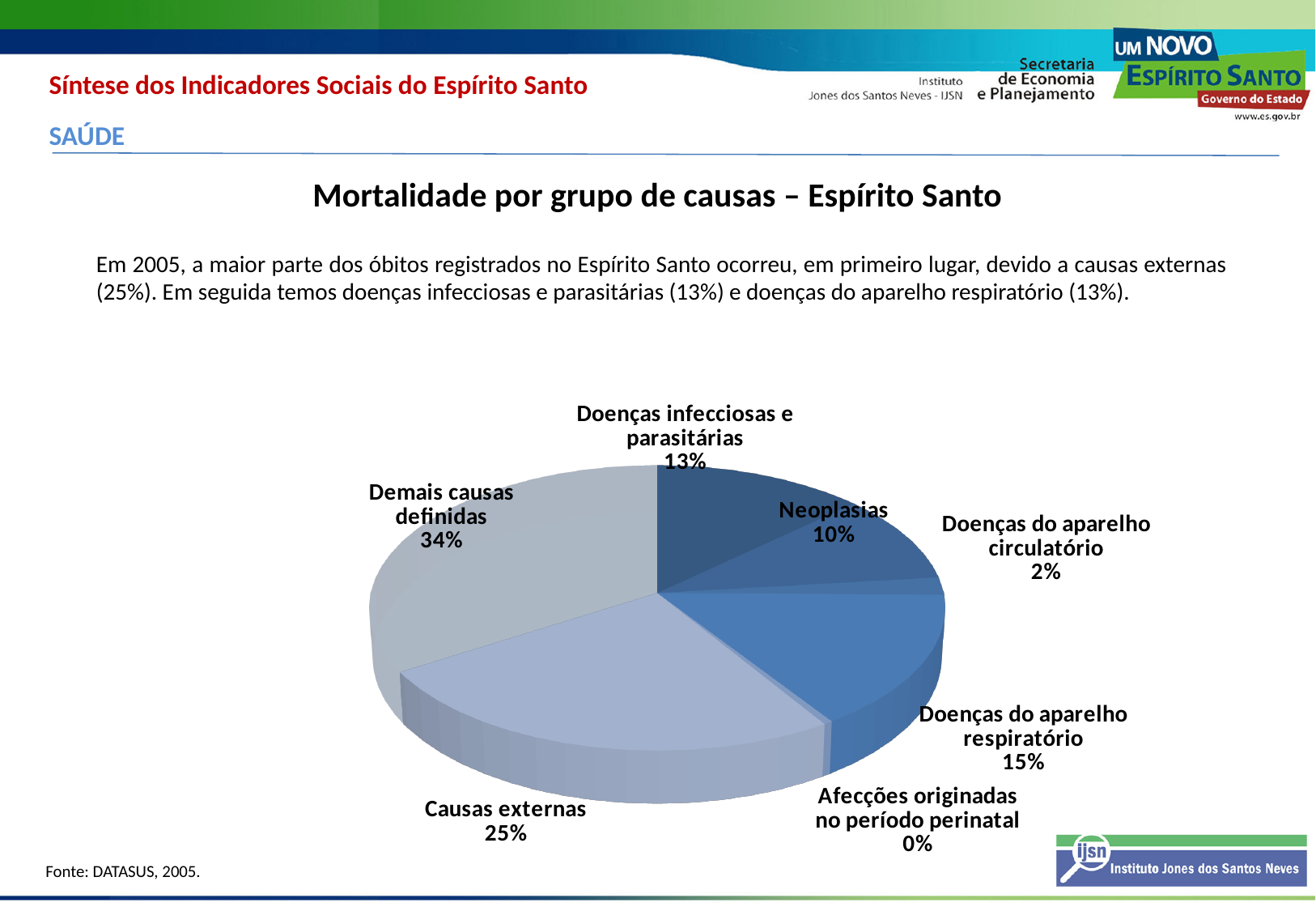
What share of the pie is labelled for Causas externas? 25% Which group of causes has the largest slice of the pie? Demais causas definidas What percentage is shown for Doenças do aparelho circulatório? 2% What percentage is shown for Neoplasias? 10% What kind of chart is shown on the slide? pie chart How many categories (slices) are labelled in the pie chart? 7 Which is larger, the share for Neoplasias or the share for Doenças do aparelho respiratório? Doenças do aparelho respiratório What percentage is shown for Doenças do aparelho respiratório? 15% Which group of causes has the smallest share in the pie chart? Afecções originadas no período perinatal What is the difference in percentage points between Causas externas and Doenças infecciosas e parasitárias? 12 What percentage is shown for Demais causas definidas? 34% What is the title of the chart on the slide? Mortalidade por grupo de causas – Espírito Santo